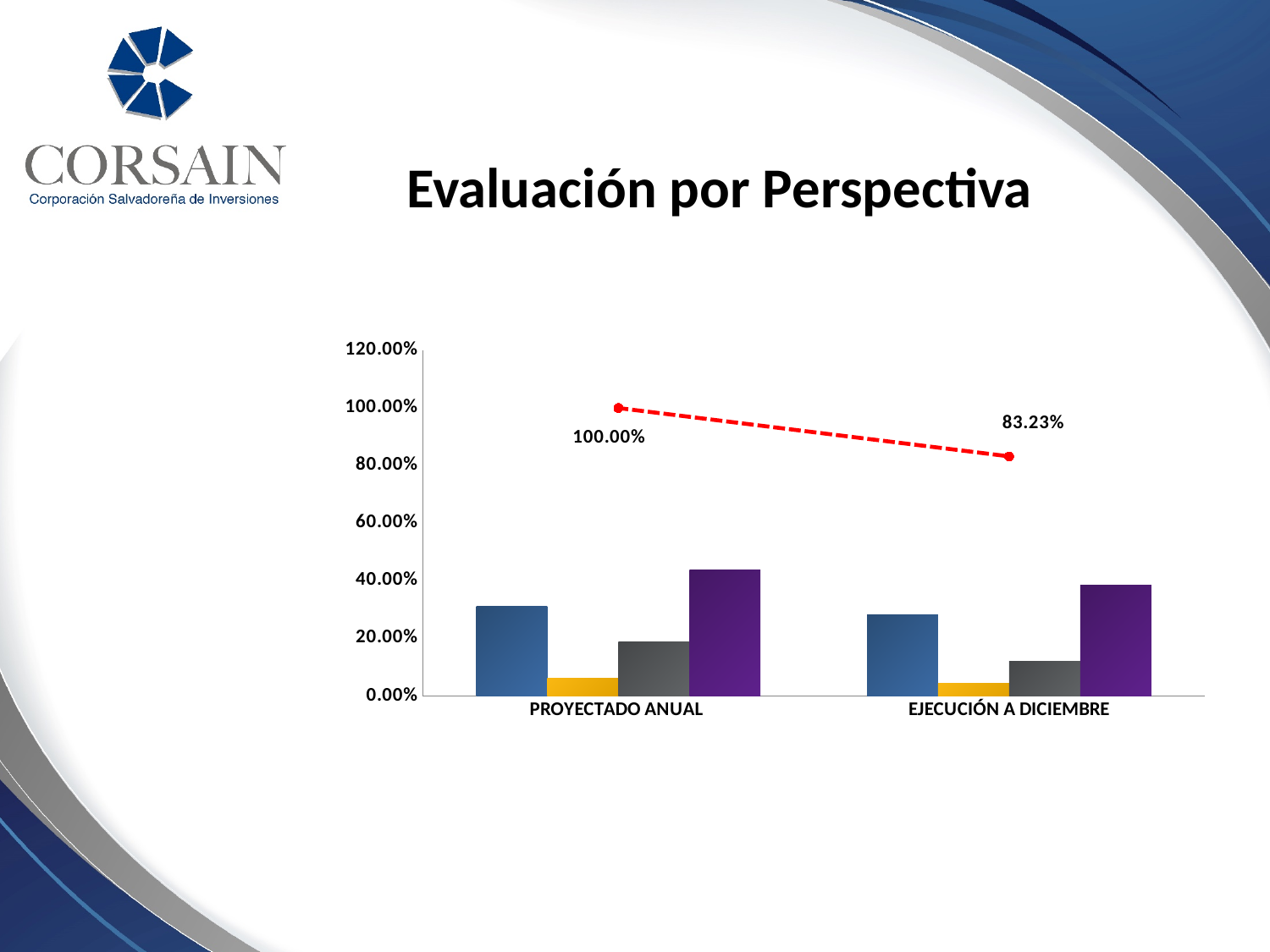
Which category has the larger line value, PROYECTADO ANUAL or EJECUCIÓN A DICIEMBRE? PROYECTADO ANUAL Which coloured bar is the tallest in the PROYECTADO ANUAL group? purple What is the title of the slide above the chart? Evaluación por Perspectiva Is the value of the blue bar for PROYECTADO ANUAL greater or less than 40.00%? less What is the value of the dashed line at PROYECTADO ANUAL? 100.00% What is the value of the dashed line at EJECUCIÓN A DICIEMBRE? 83.23% What kind of chart is shown on the slide? combined bar and line chart What is the difference between the line values at PROYECTADO ANUAL and EJECUCIÓN A DICIEMBRE? 16.77% Is the value of the gray bar for EJECUCIÓN A DICIEMBRE greater or less than 20.00%? less Which coloured bar is the shortest in the EJECUCIÓN A DICIEMBRE group? yellow Does the dashed line rise or fall from PROYECTADO ANUAL to EJECUCIÓN A DICIEMBRE? fall How many categories are shown on the x axis? 2